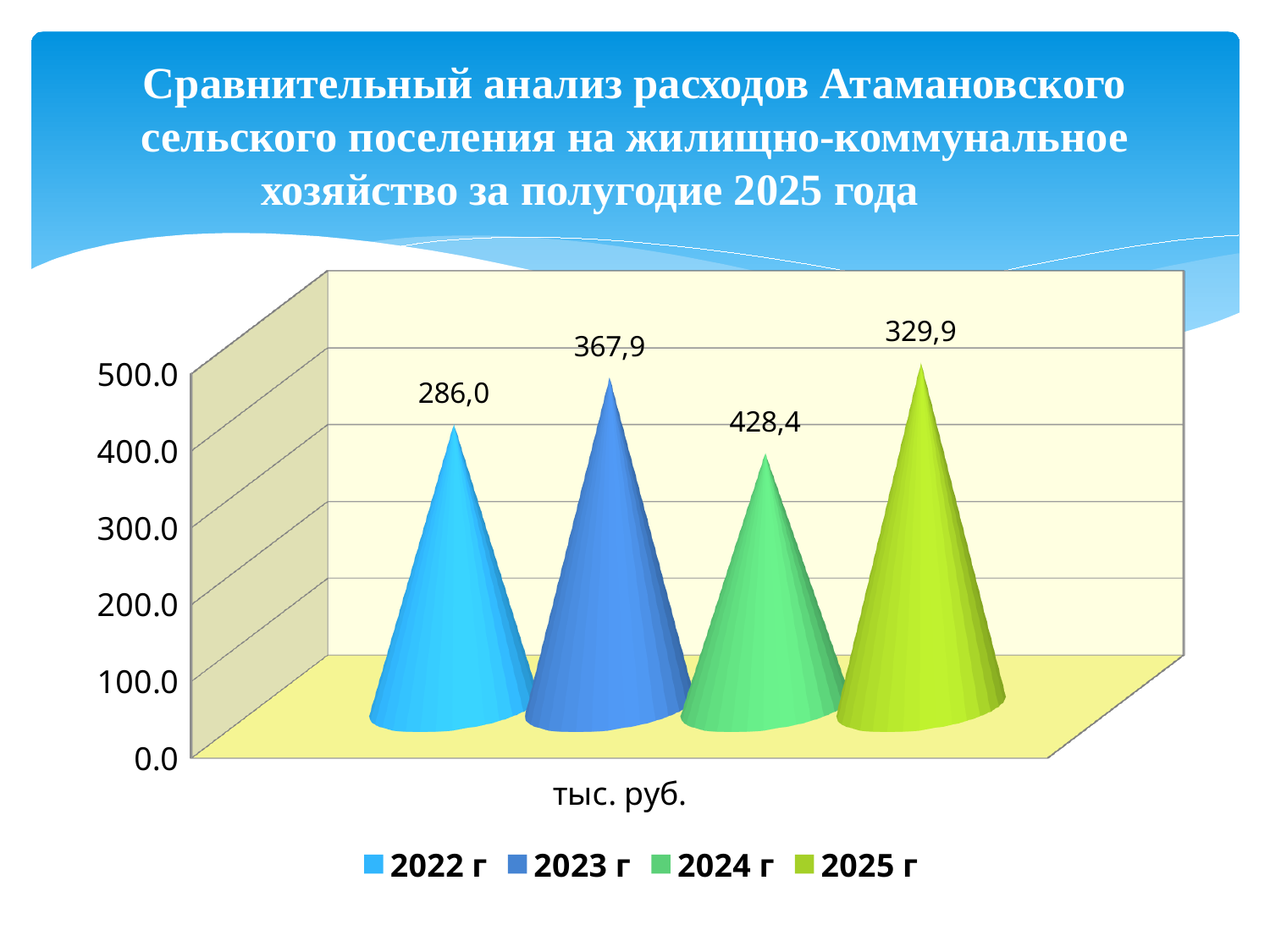
What is the value shown for 2024 г? 428,4 What is the value shown for 2022 г? 286,0 What is the difference between the labelled values for 2023 г and 2022 г? 81,9 What is the value shown for 2025 г? 329,9 What is the difference between the labelled values for 2024 г and 2025 г? 98,5 What unit label is shown below the chart's horizontal axis? тыс. руб. How many bars are plotted on the chart? 4 What is the difference between the labelled values for 2024 г and 2023 г? 60,5 How many series does the legend list? 4 What kind of chart is shown on the slide? Bar chart Which legend entry is shown in light blue? 2022 г What is the value shown for 2023 г? 367,9